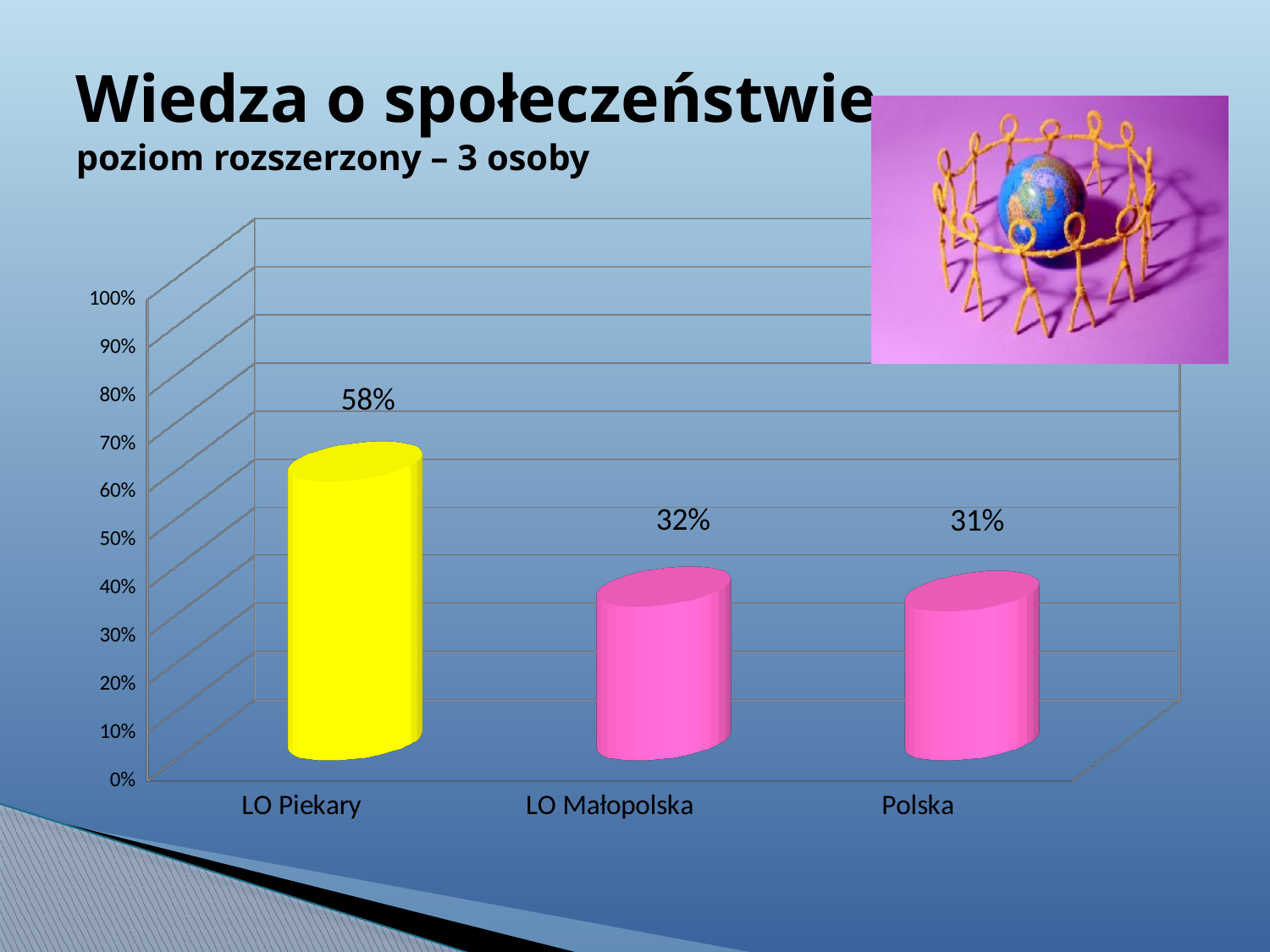
What is the difference between the values for LO Piekary and LO Małopolska? 26% What is the difference between the values for LO Piekary and Polska? 27% Which is larger, the value for LO Piekary or the value for Polska? LO Piekary Is the value for LO Piekary greater or less than 50%? greater What kind of chart is shown on the slide? bar chart What is the value for LO Piekary? 58% What is the value for LO Małopolska? 32% What colour is the bar for LO Piekary? yellow How many categories are shown on the x axis? 3 What is the value for Polska? 31% Which category has the highest value? LO Piekary Is the value for Polska greater or less than 40%? less